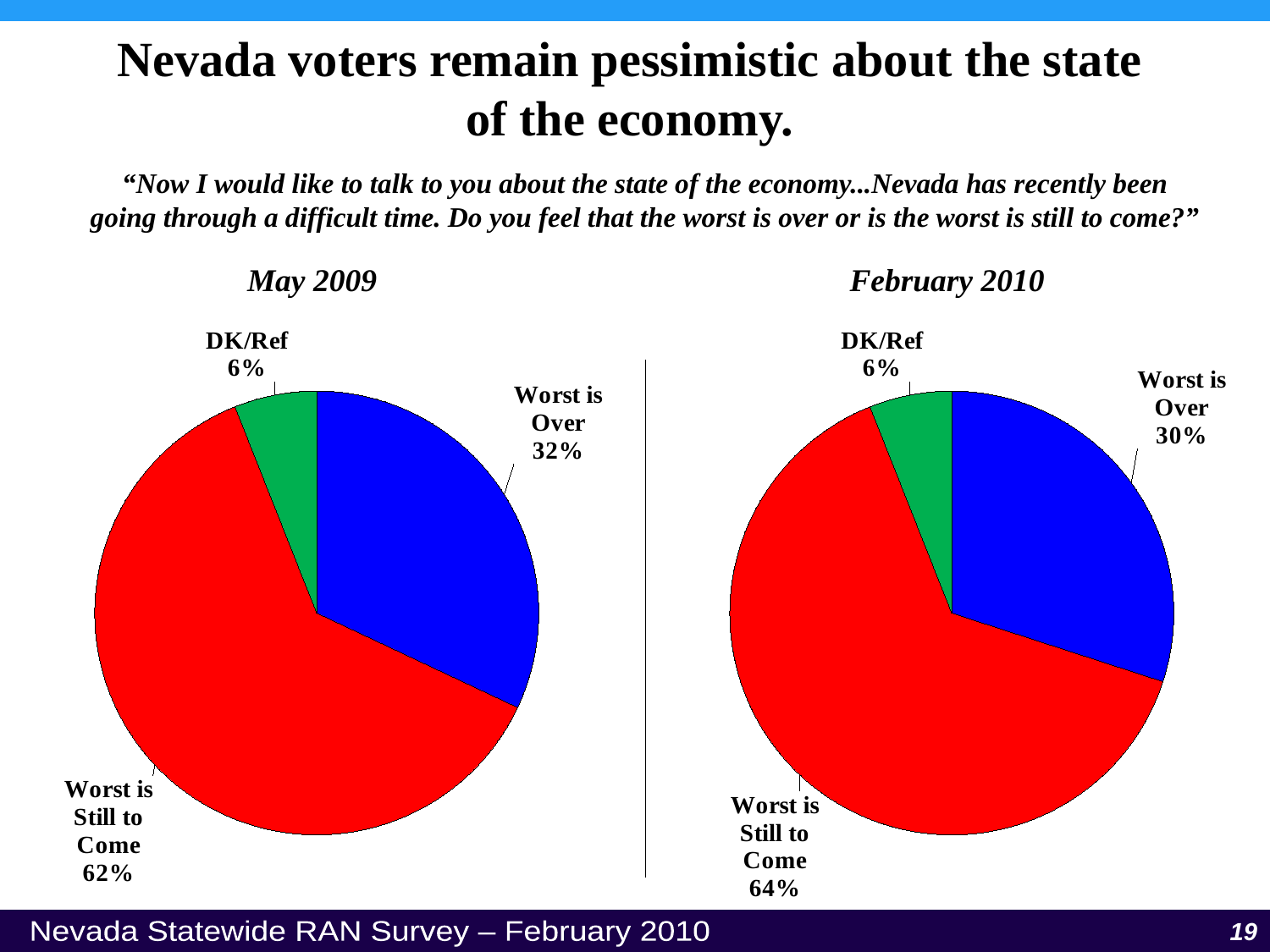
In the February 2010 chart, which response has the smallest share? DK/Ref What is the difference between the 'Worst is Over' share in May 2009 and in February 2010? 2% What is the title of the chart on the right side of the slide? February 2010 In the May 2009 chart, which response has the largest share? Worst is Still to Come In the February 2010 chart, what percentage said the worst is over? 30% In the May 2009 chart, what percentage said the worst is still to come? 62% What type of chart is used on this slide? Pie chart How many slices does the February 2010 pie chart have? 3 In the May 2009 chart, what is the difference between the 'Worst is Still to Come' and 'Worst is Over' shares? 30% In the February 2010 chart, what percentage is DK/Ref? 6% In the May 2009 chart, what colour is the 'Worst is Over' slice? Blue Which chart shows a larger share for 'Worst is Still to Come', May 2009 or February 2010? February 2010